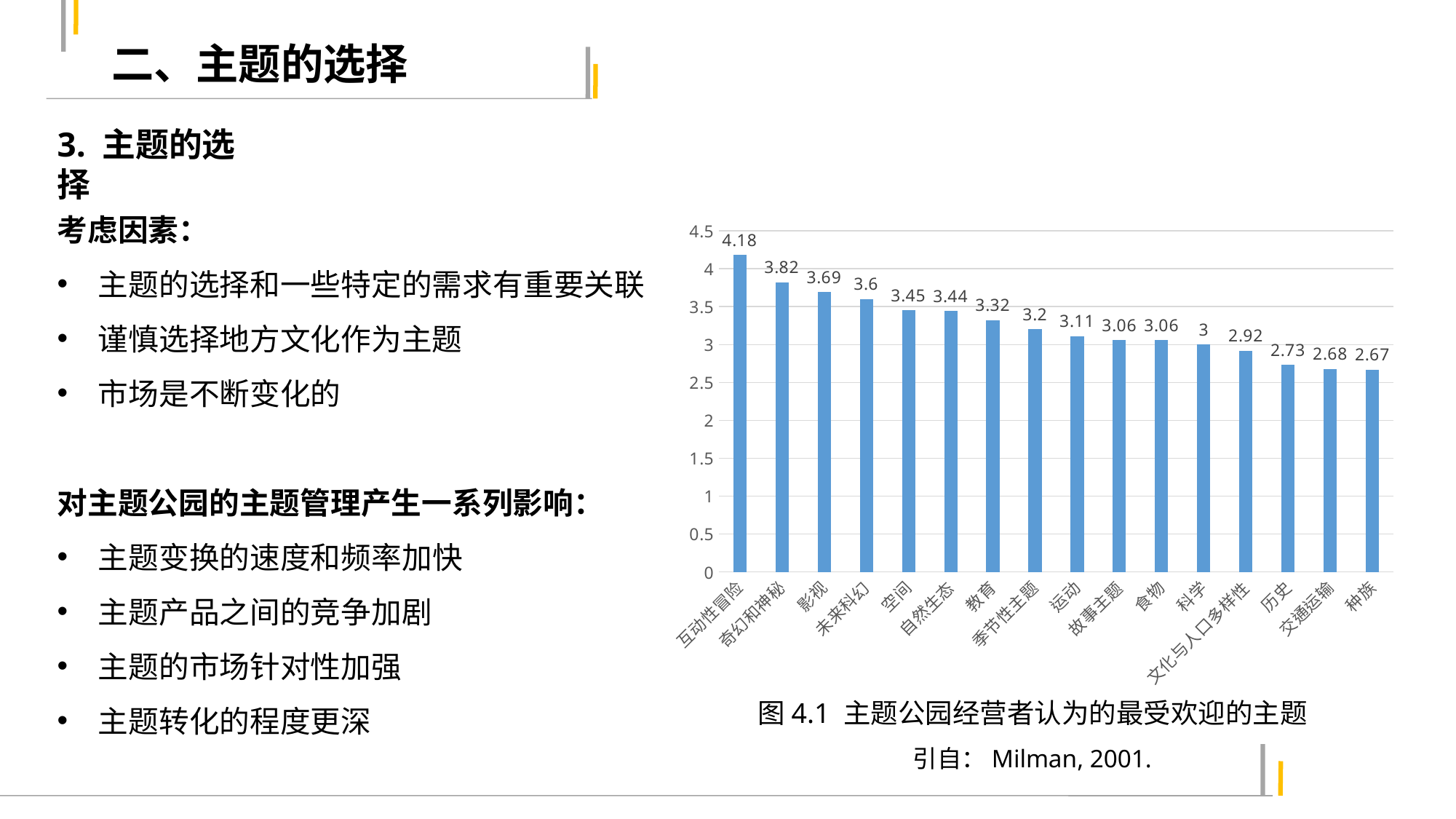
What is the difference between the values for 互动性冒险 and 奇幻和神秘? 0.36 How many categories are shown in the chart? 16 What is the difference between the values for 影视 and 历史? 0.96 What is the title of the chart? 图 4.1 主题公园经营者认为的最受欢迎的主题 What is the value for 文化与人口多样性? 2.92 Which category has the highest value? 互动性冒险 What is the value for 互动性冒险? 4.18 What kind of chart is shown on the slide? bar chart Is the value for 季节性主题 greater or less than 3? greater Which category has the lowest value? 种族 What is the value for 教育? 3.32 Which is larger, the value for 未来科幻 or the value for 运动? 未来科幻